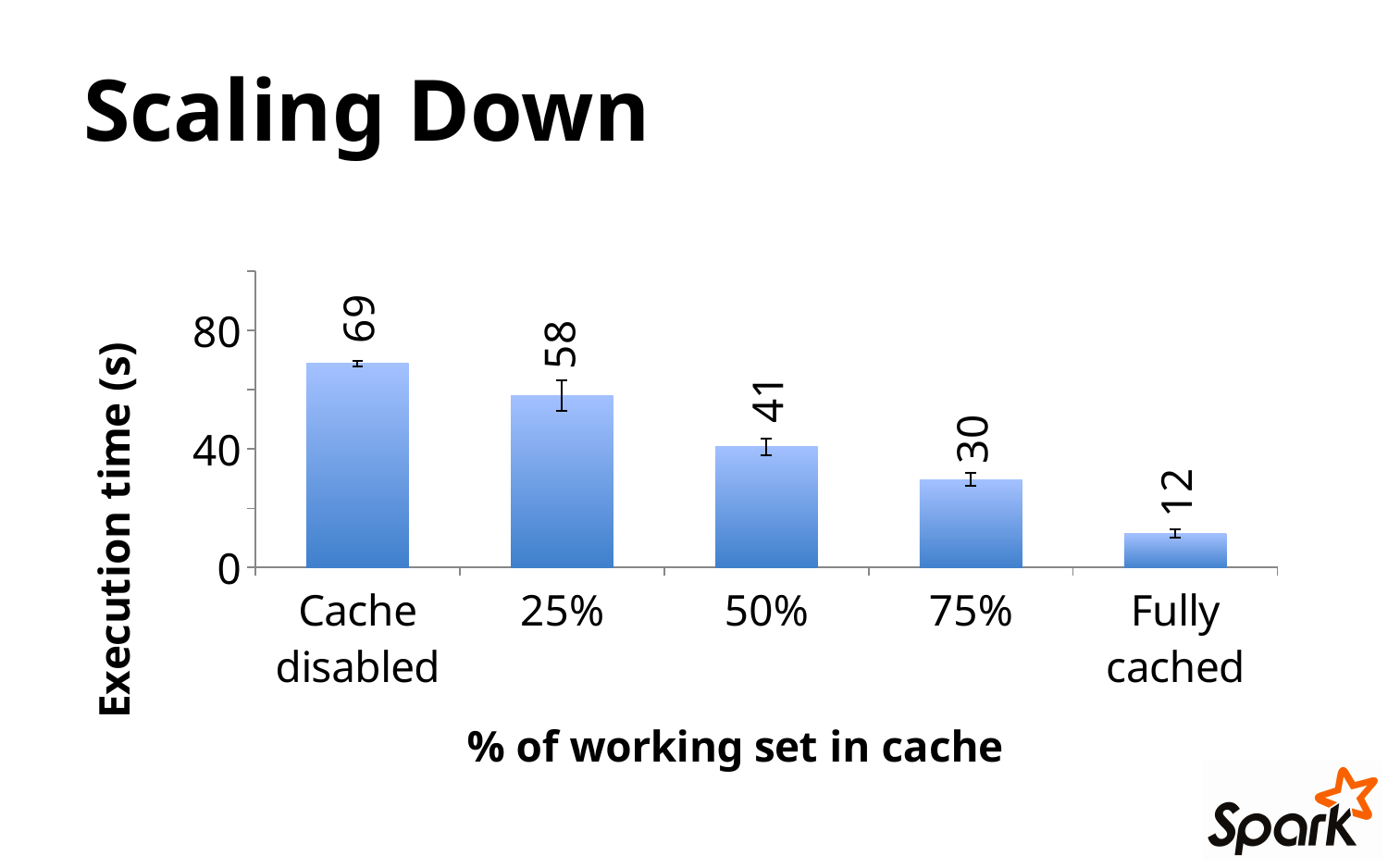
What is the execution time when the cache is disabled? 69 Do the execution times rise or fall as the percentage of the working set in cache increases? Fall What is the difference in execution time between Cache disabled and Fully cached? 57 How many categories are shown on the x axis? 5 Which category has the lowest execution time? Fully cached Which category has the highest execution time? Cache disabled Is the execution time for 25% greater or less than 40? greater What kind of chart is shown on the slide? Bar chart What is the difference in execution time between 25% and 75% of the working set in cache? 28 Which has a larger execution time, 50% or 75% of the working set in cache? 50% What is the execution time when fully cached? 12 What is the execution time with 50% of the working set in cache? 41